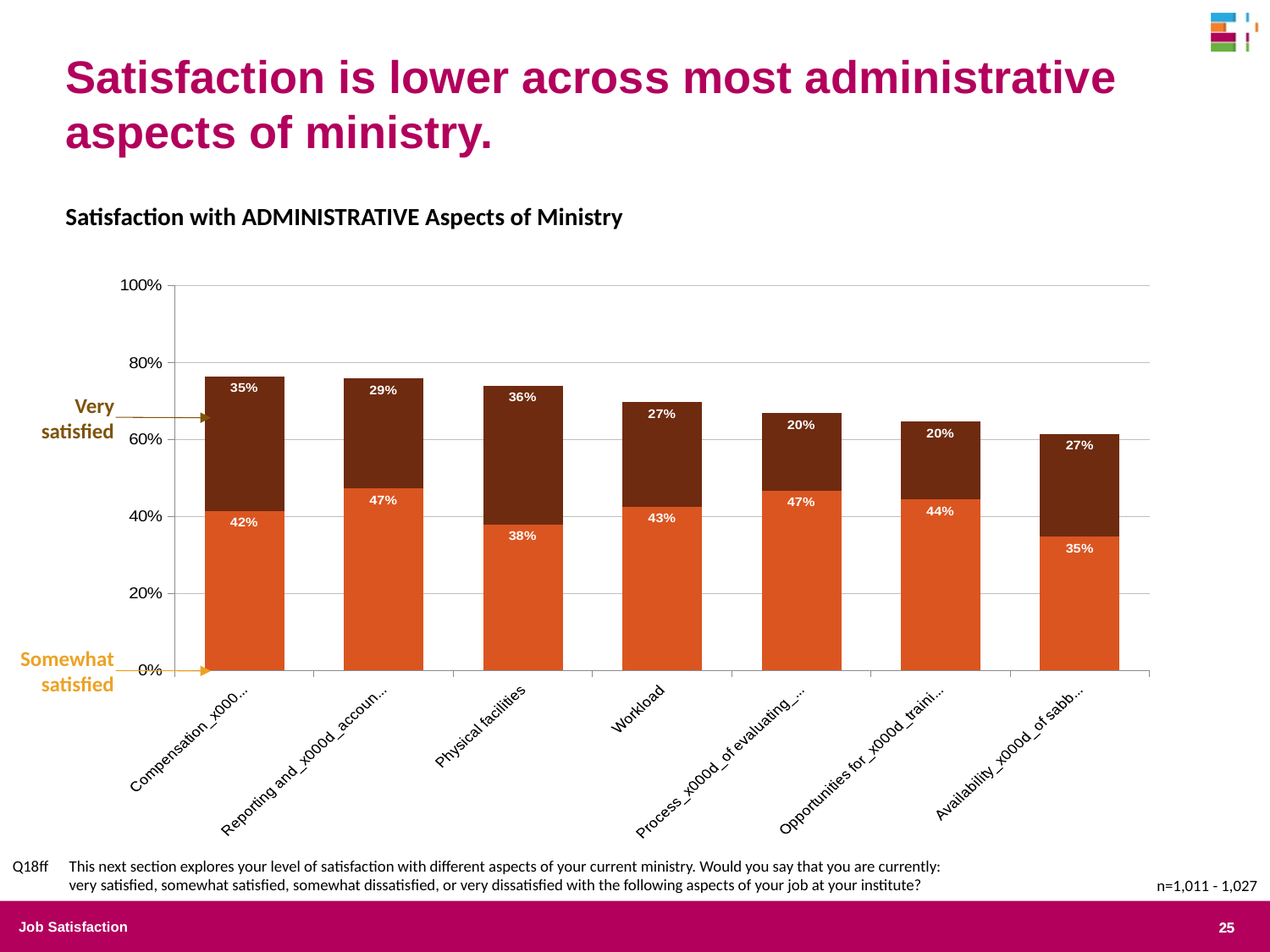
What is the combined total of the Physical facilities bar? 74% What percentage of respondents are very satisfied with Physical facilities? 36% What is the very satisfied percentage for Compensation? 35% What percentage of respondents are somewhat satisfied with Workload? 43% What type of chart is shown? Stacked bar chart For Physical facilities, what is the difference between the somewhat satisfied and very satisfied percentages? 2% Which has a higher somewhat satisfied percentage, Workload or Physical facilities? Workload Do the total bar heights rise or fall from left to right across the x axis? Fall How many aspects of ministry are shown on the x axis? 7 How many series are stacked in each bar? 2 What is the combined (very plus somewhat satisfied) total for the Workload bar? 70% Which aspect has the highest very satisfied percentage? Physical facilities